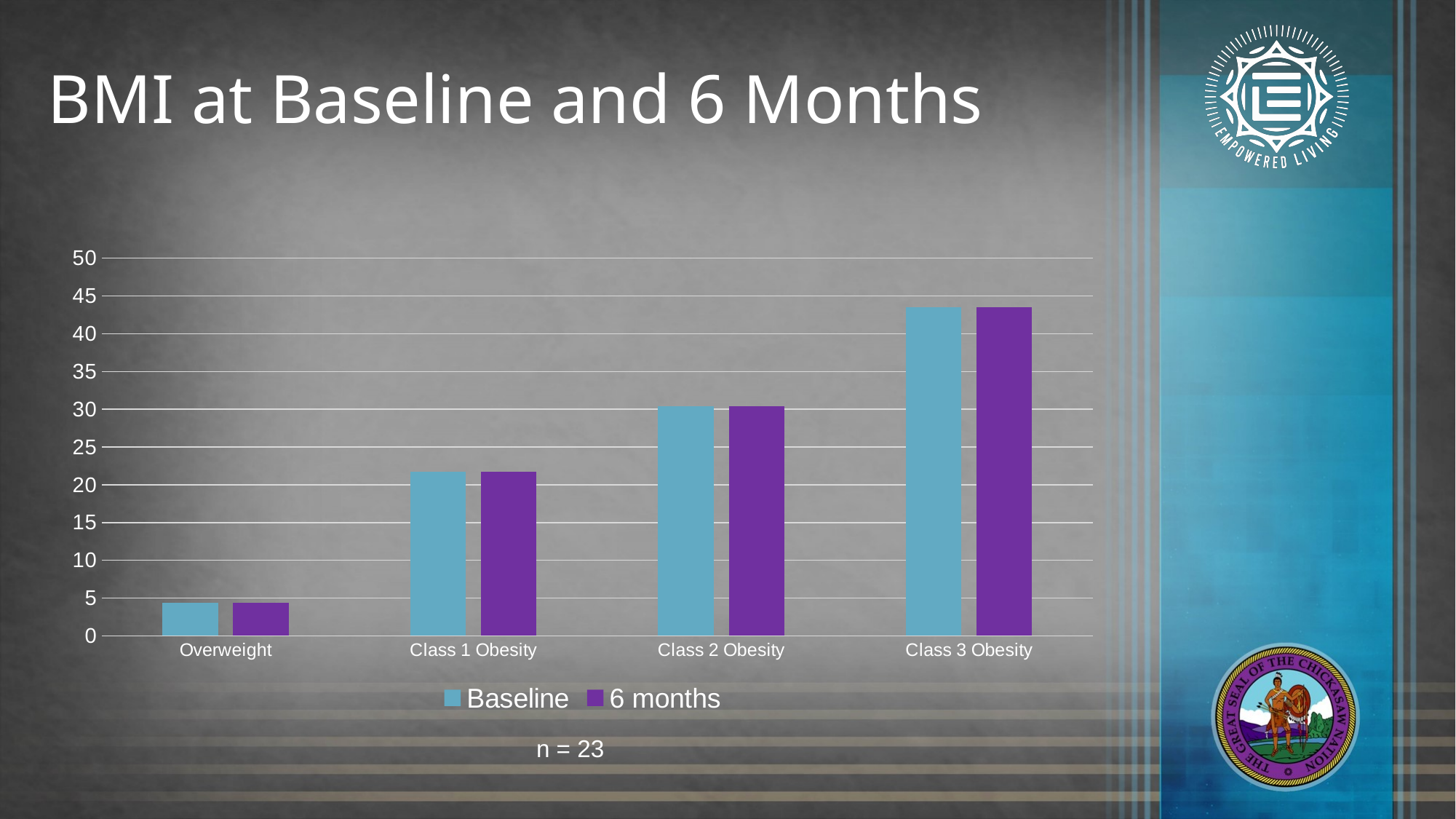
Which category has the highest Baseline value? Class 3 Obesity Which is larger, the Baseline value for Class 3 Obesity or the Baseline value for Class 1 Obesity? Class 3 Obesity Is the 6 months value for Class 3 Obesity greater or less than 40? greater Which category has the lowest 6 months value? Overweight How many categories are shown on the x axis of the chart? 4 What is the title of the chart on the slide? BMI at Baseline and 6 Months What kind of chart is shown on the slide? bar chart Is the Baseline value for Class 2 Obesity greater or less than 35? less Is the Baseline value for Class 1 Obesity greater or less than 20? greater How many series does the chart's legend list? 2 Do the Baseline values rise or fall from Overweight to Class 3 Obesity? rise